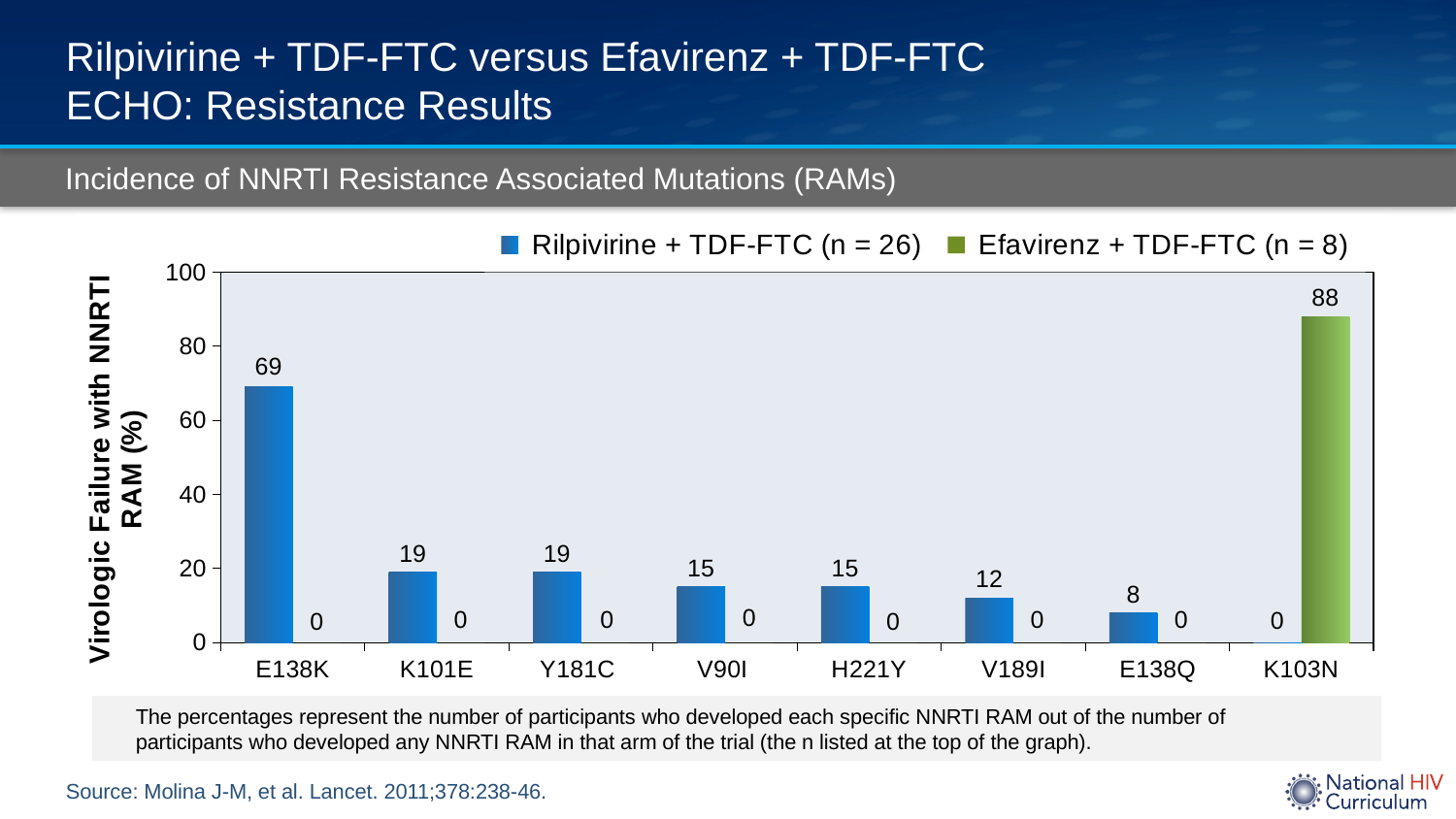
How many series does the legend list? 2 What is the difference between the Rilpivirine + TDF-FTC value for E138K and the Rilpivirine + TDF-FTC value for E138Q? 61 Which is larger: the Rilpivirine + TDF-FTC value for K101E or the Rilpivirine + TDF-FTC value for V90I? K101E What is the label of the y axis? Virologic Failure with NNRTI RAM (%) What is the value for K103N in the Efavirenz + TDF-FTC (n = 8) series? 88 Which mutation has the highest value in the Rilpivirine + TDF-FTC (n = 26) series? E138K What is the value for E138K in the Efavirenz + TDF-FTC (n = 8) series? 0 What kind of chart is shown on the slide? Bar chart How many mutation categories are shown on the x axis? 8 What is the value for V189I in the Rilpivirine + TDF-FTC (n = 26) series? 12 What is the value for E138K in the Rilpivirine + TDF-FTC (n = 26) series? 69 Which mutation has the lowest value in the Rilpivirine + TDF-FTC (n = 26) series? K103N